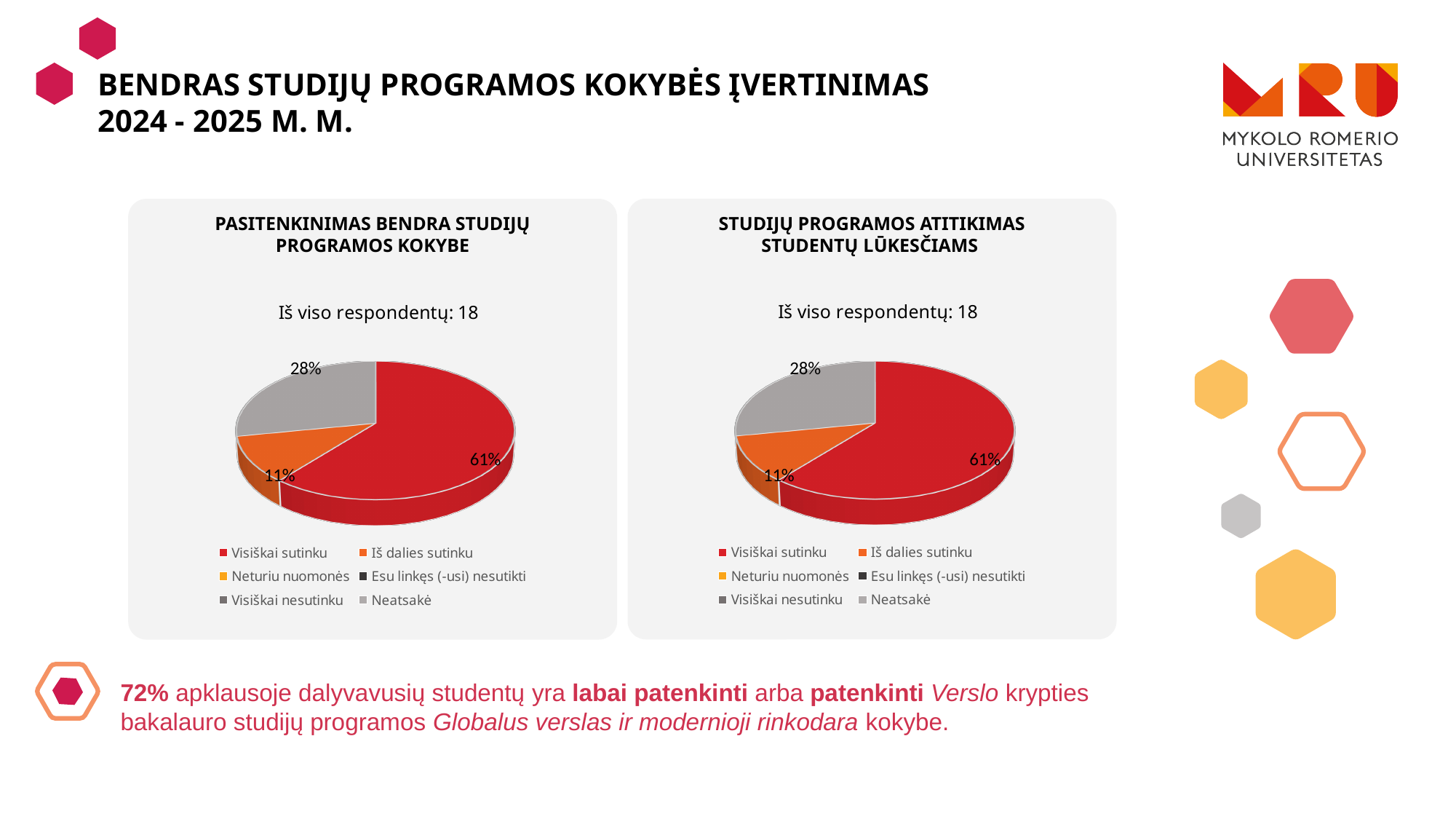
What type of chart is used in the "Pasitenkinimas bendra studijų programos kokybe" panel? Pie chart In the right chart, which of the labelled slices is the smallest? Iš dalies sutinku In the chart titled "Pasitenkinimas bendra studijų programos kokybe", what share of respondents answered "Visiškai sutinku"? 61% In the chart titled "Studijų programos atitikimas studentų lūkesčiams", what share of respondents is labelled "Neatsakė"? 28% How many respondents in total are reported for the chart titled "Studijų programos atitikimas studentų lūkesčiams"? 18 In the left chart, what is the difference in percentage points between the "Visiškai sutinku" slice and the "Neatsakė" slice? 33 percentage points In the chart titled "Pasitenkinimas bendra studijų programos kokybe", what share of respondents answered "Iš dalies sutinku"? 11% In the left chart, what colour is the "Visiškai sutinku" slice? Red In the right chart, which slice is larger: "Neatsakė" or "Iš dalies sutinku"? Neatsakė In the chart titled "Studijų programos atitikimas studentų lūkesčiams", what share of respondents answered "Visiškai sutinku"? 61% How many entries does the legend of the left chart list? 6 In the left chart, which category has the largest slice? Visiškai sutinku